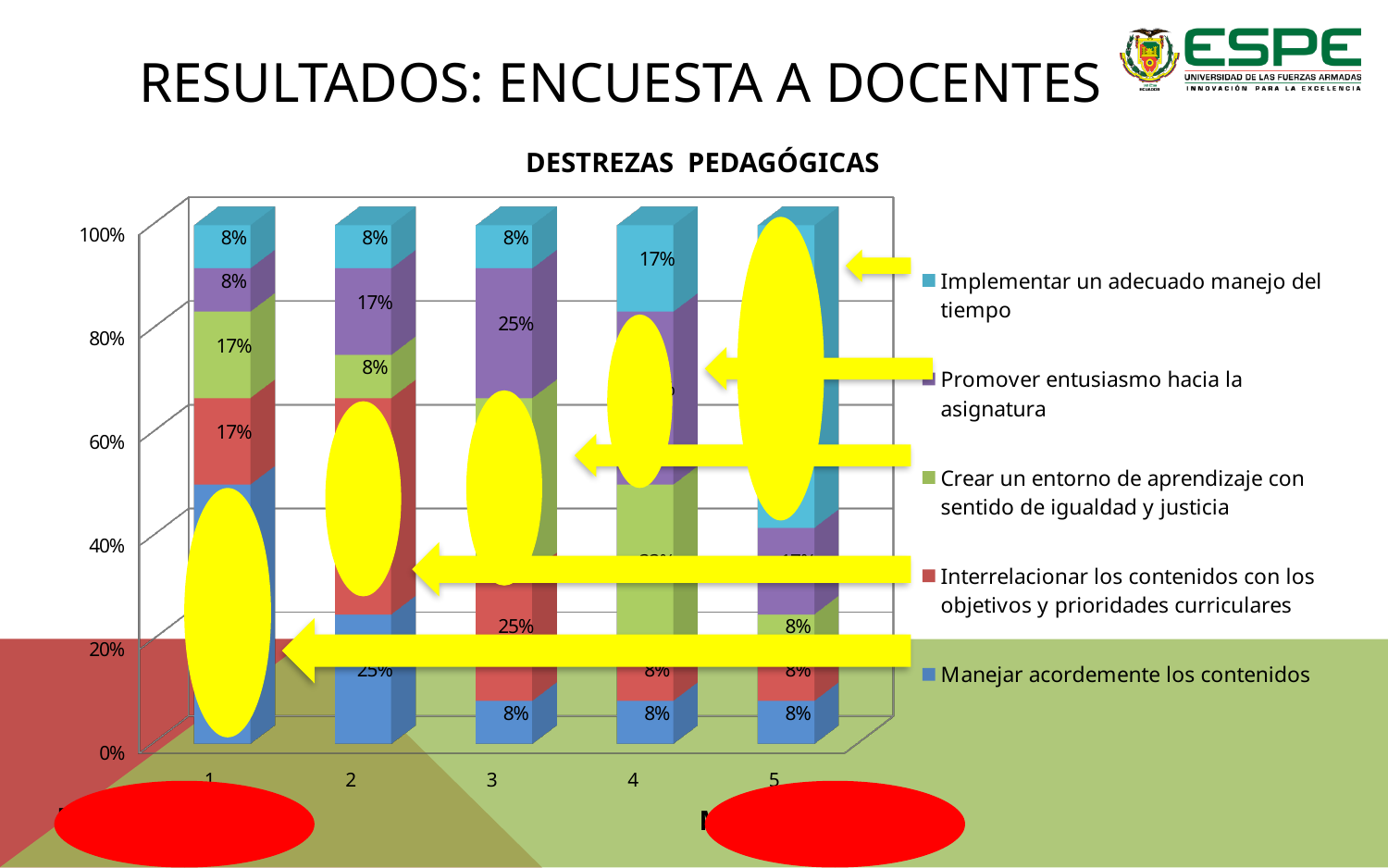
What is the difference between the 'Promover entusiasmo hacia la asignatura' values for category 3 and category 1? 17% What is the value of 'Promover entusiasmo hacia la asignatura' for category 3? 25% What kind of chart is shown on the slide? Stacked bar chart How many categories are shown along the x axis of the chart? 5 What is the value of 'Implementar un adecuado manejo del tiempo' for category 4? 17% What is the value of 'Manejar acordemente los contenidos' for category 3? 8% Which colour represents 'Manejar acordemente los contenidos' in the legend? Blue Which is larger for 'Promover entusiasmo hacia la asignatura': category 1 or category 3? Category 3 How many series does the chart legend list? 5 What is the value of 'Crear un entorno de aprendizaje con sentido de igualdad y justicia' for category 1? 17% What is the title of the chart? DESTREZAS PEDAGÓGICAS What is the value of 'Implementar un adecuado manejo del tiempo' for category 1? 8%